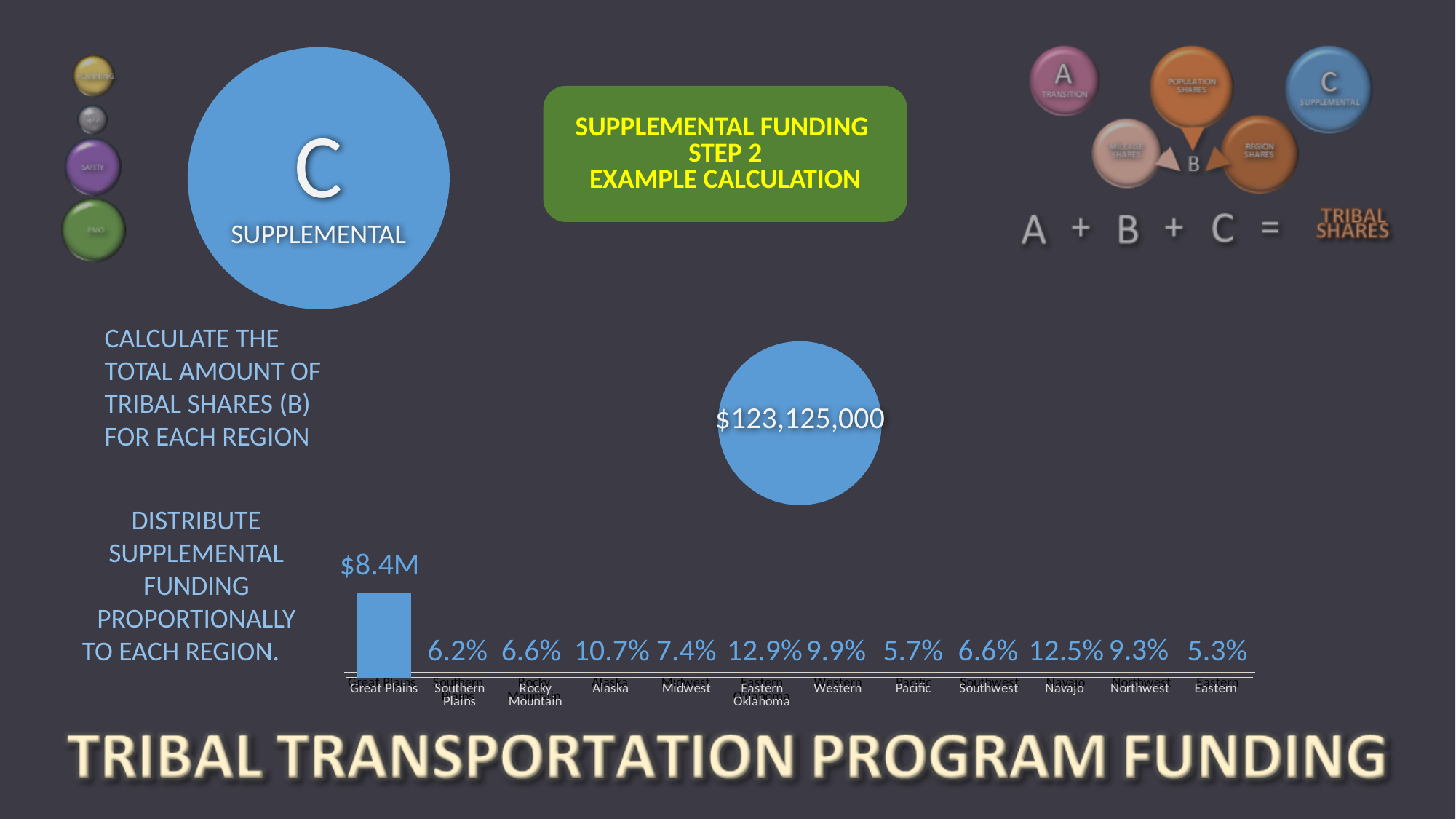
What kind of chart is shown at the bottom of the slide? bar chart What percentage is shown for Alaska in the bar chart? 10.7% What percentage is shown for Navajo in the bar chart? 12.5% Which has the larger percentage label, Western or Northwest? Western What percentage is shown for Pacific in the bar chart? 5.7% What percentage is shown for Southwest in the bar chart? 6.6% Which region has the highest percentage label in the bar chart? Eastern Oklahoma Which region has the lowest percentage label in the bar chart? Eastern What value is labelled on the bar for Great Plains? $8.4M What is the difference between the percentages shown for Eastern Oklahoma and Navajo? 0.4% How many regions are listed along the x axis of the bar chart? 12 What is the difference between the percentages shown for Alaska and Midwest? 3.3%